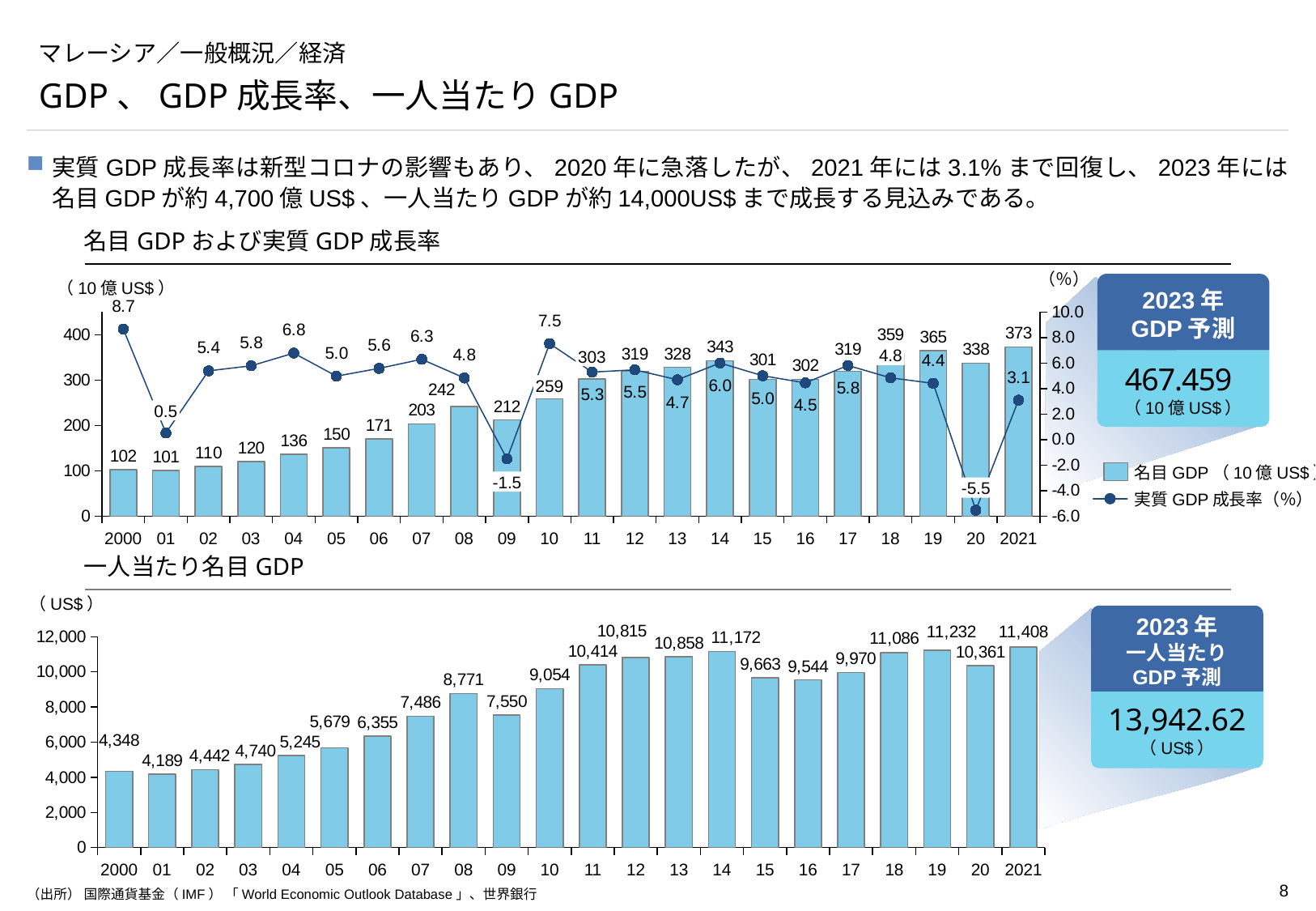
In the bottom chart (一人当たり名目GDP), which is larger, the value for 2015 or the value for 2016? 2015 In the top chart (名目GDPおよび実質GDP成長率), which year has the lowest nominal GDP? 01 In the bottom chart (一人当たり名目GDP), what is the value for 2008? 8,771 In the bottom chart (一人当たり名目GDP), which year has the lowest value? 01 What kind of chart is the bottom chart (一人当たり名目GDP)? Bar chart In the top chart (名目GDPおよび実質GDP成長率), what is the real GDP growth rate for 2020? -5.5 In the top chart (名目GDPおよび実質GDP成長率), what is the nominal GDP value for 2021? 373 In the bottom chart (一人当たり名目GDP), which year has the highest value? 2021 In the top chart (名目GDPおよび実質GDP成長率), what is the difference in nominal GDP between 2019 and 2020? 27 In the top chart (名目GDPおよび実質GDP成長率), how many series does the legend list? 2 In the top chart (名目GDPおよび実質GDP成長率), which year has the highest real GDP growth rate? 2000 In the bottom chart (一人当たり名目GDP), how many years are plotted? 22